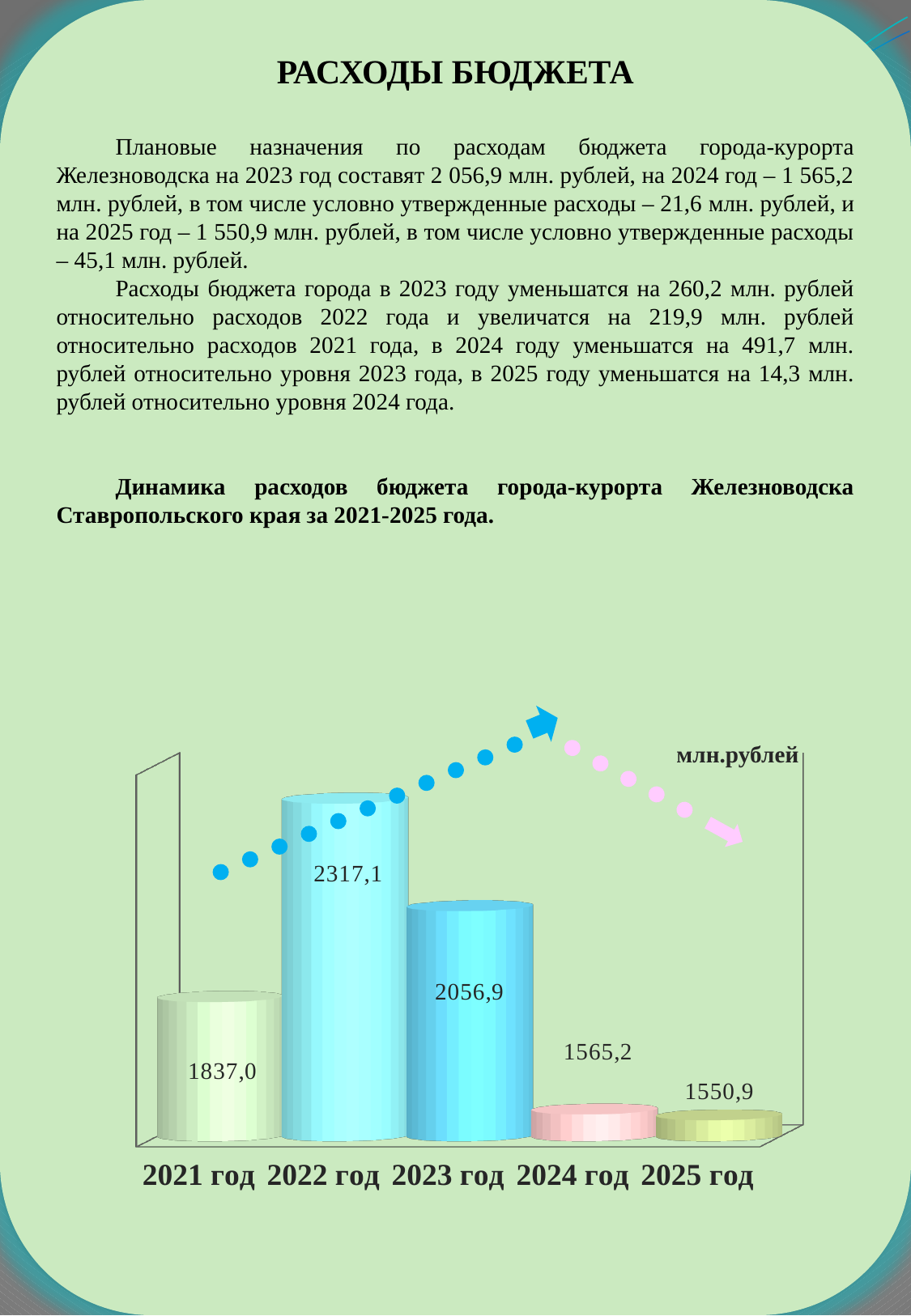
What is the value for 2023 год? 2056,9 What is the value for 2021 год? 1837,0 What is the difference between the values for 2022 год and 2023 год? 260,2 Which year has the highest value? 2022 год What is the difference between the values for 2023 год and 2024 год? 491,7 Which year has the lowest value? 2025 год What unit is shown on the chart? млн.рублей Which is larger, the value for 2021 год or the value for 2023 год? 2023 год What kind of chart is this? bar chart Do the values rise or fall from 2022 год to 2025 год? fall What is the value for 2025 год? 1550,9 How many years are shown on the chart? 5